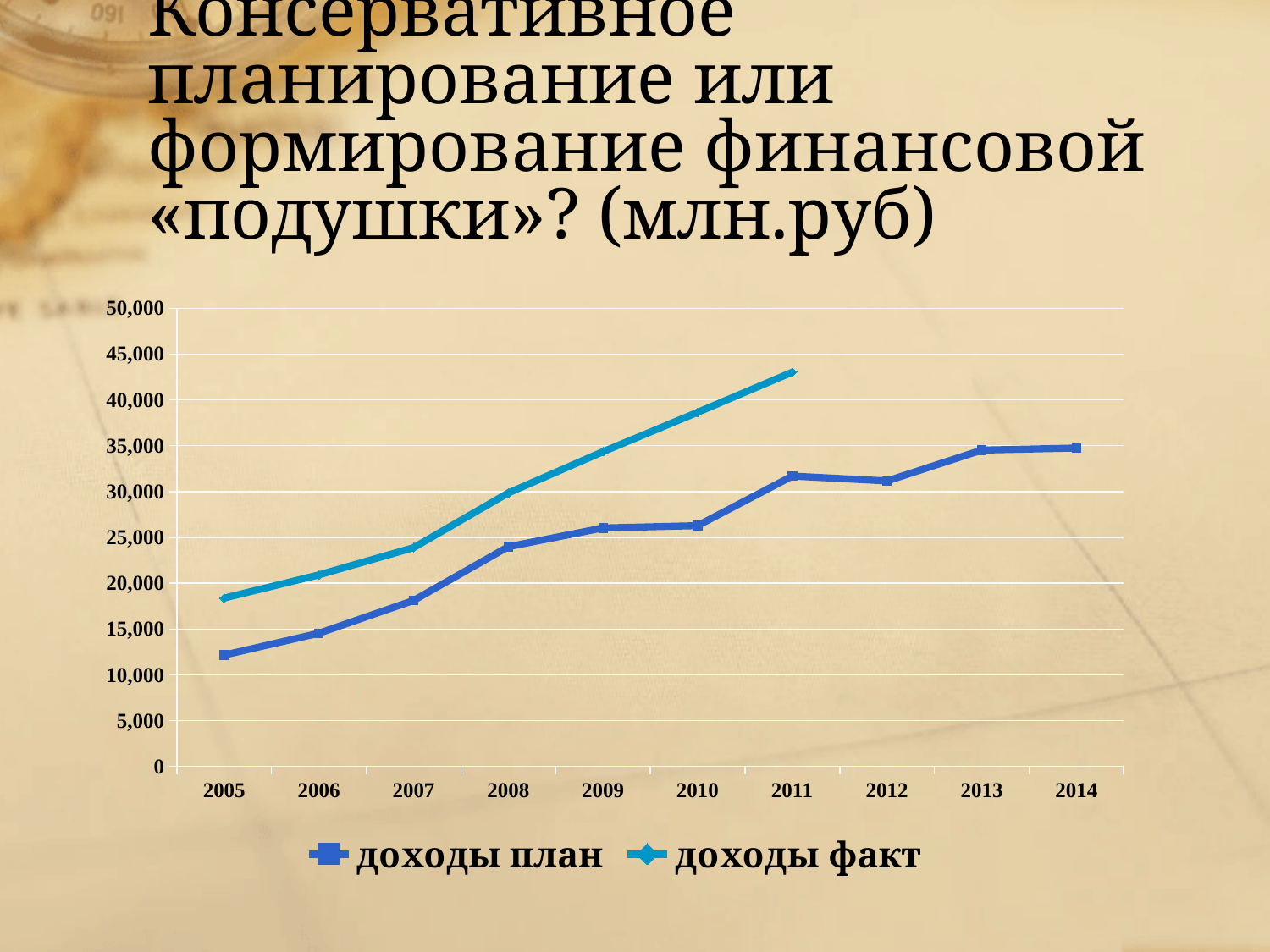
In which year is the 'доходы план' series at its lowest? 2005 Does the 'доходы факт' series rise or fall from 2005 to 2011? rise How many series does the legend list? 2 Is the value for 'доходы план' in 2005 greater or less than 15,000? less What kind of chart is shown on the slide? line chart How many years are shown on the x axis? 10 Which series is plotted in the lighter cyan colour? доходы факт What is the last year for which the 'доходы факт' series has a data point? 2011 Is the value for 'доходы факт' in 2011 greater or less than 40,000? greater In 2010, which series has the larger value, 'доходы план' or 'доходы факт'? доходы факт Is the value for 'доходы план' in 2014 greater or less than 30,000? greater In which year does the 'доходы факт' series reach its highest value? 2011